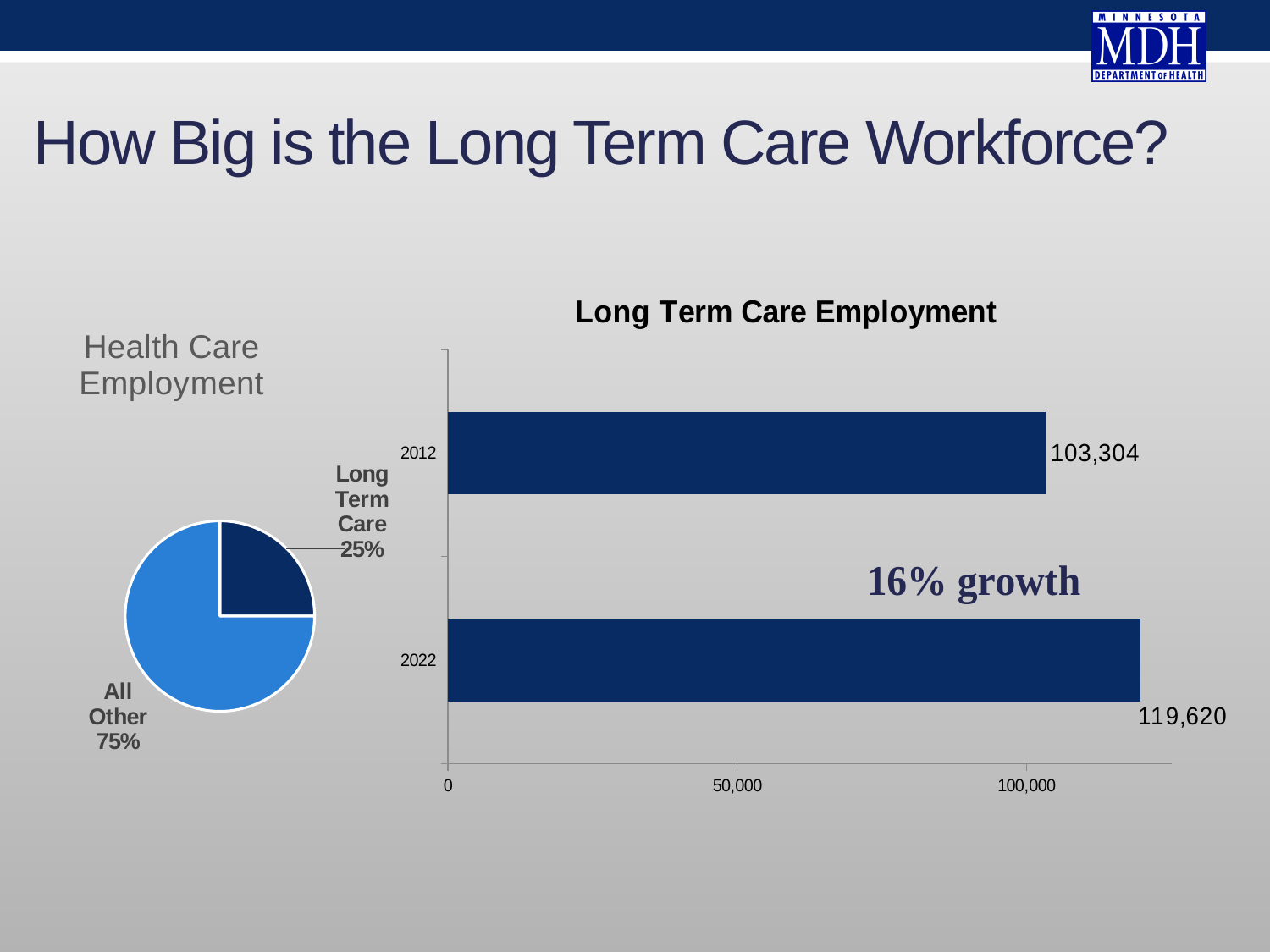
What growth percentage is annotated on the Long Term Care Employment chart? 16% growth In the Long Term Care Employment chart, how many bars are plotted? 2 In the Long Term Care Employment chart, is the value for 2012 greater or less than 100,000? greater In the Long Term Care Employment chart, which year has the higher value? 2022 What kind of chart is the Long Term Care Employment chart? bar chart In the Long Term Care Employment chart, what is the value for 2012? 103,304 In the Health Care Employment pie chart, what share is All Other? 75% In the Long Term Care Employment chart, which year has the lower value? 2012 In the Health Care Employment pie chart, what share is Long Term Care? 25% In the Long Term Care Employment chart, what is the value for 2022? 119,620 In the Long Term Care Employment chart, what is the difference between the 2022 and 2012 values? 16,316 In the Health Care Employment pie chart, which slice is larger, Long Term Care or All Other? All Other